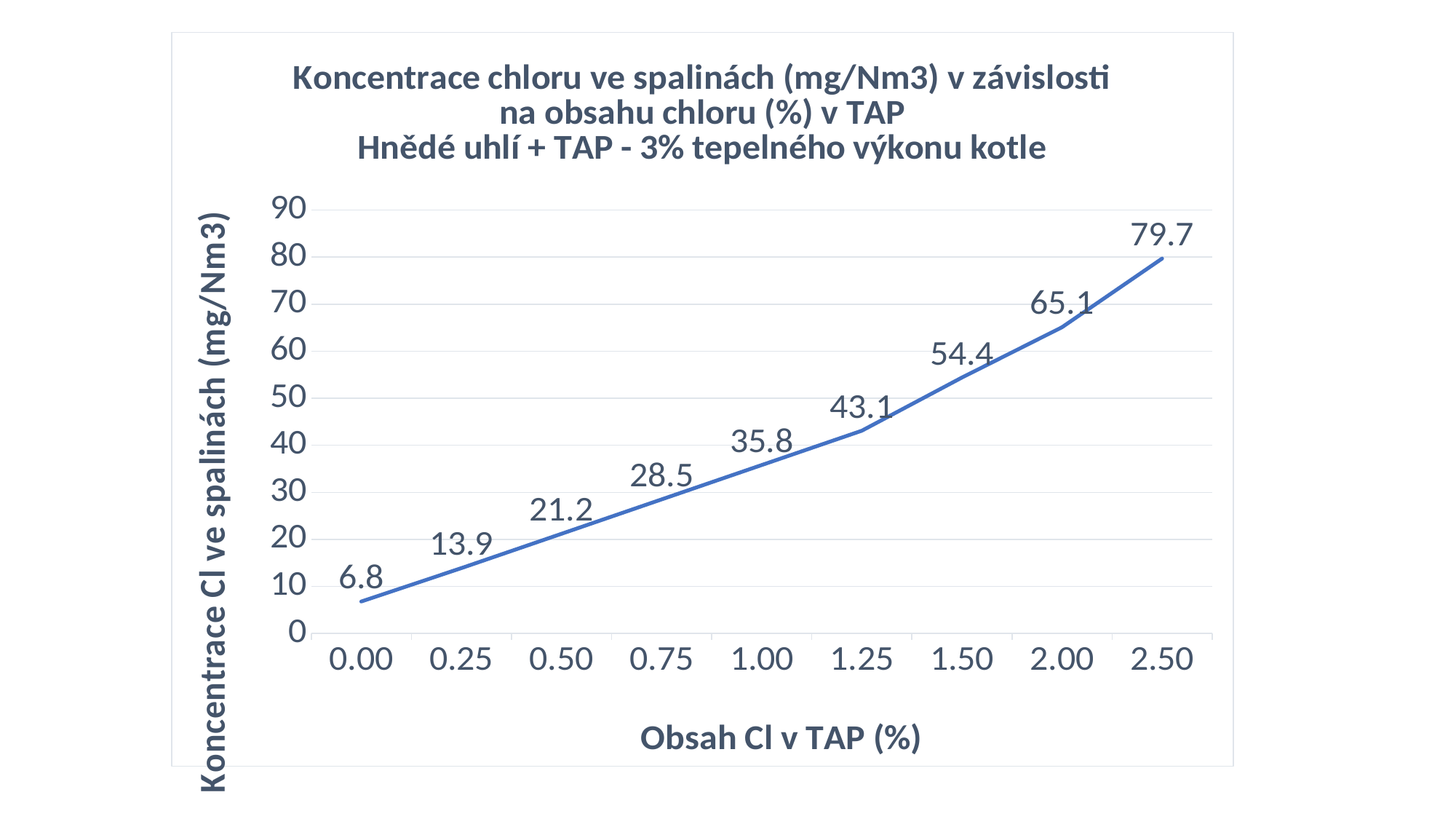
What is the chlorine concentration in flue gas when the Cl content in TAP is 0.00%? 6.8 What is the chlorine concentration in flue gas when the Cl content in TAP is 2.00%? 65.1 Is the chlorine concentration at 1.50% Cl content in TAP greater or less than 50? greater How many data points are plotted on the chart? 9 Does the chlorine concentration in flue gas rise or fall as the Cl content in TAP increases? rise Which is larger: the chlorine concentration at 0.50% or at 1.50% Cl content in TAP? 1.50% What is the difference between the chlorine concentration at 2.50% and at 2.00% Cl content in TAP? 14.6 What kind of chart is shown on the slide? line chart What is the chlorine concentration in flue gas when the Cl content in TAP is 1.00%? 35.8 At which Cl content in TAP is the flue gas chlorine concentration lowest? 0.00 At which Cl content in TAP is the flue gas chlorine concentration highest? 2.50 What is the difference between the chlorine concentration at 1.25% and at 0.75% Cl content in TAP? 14.6